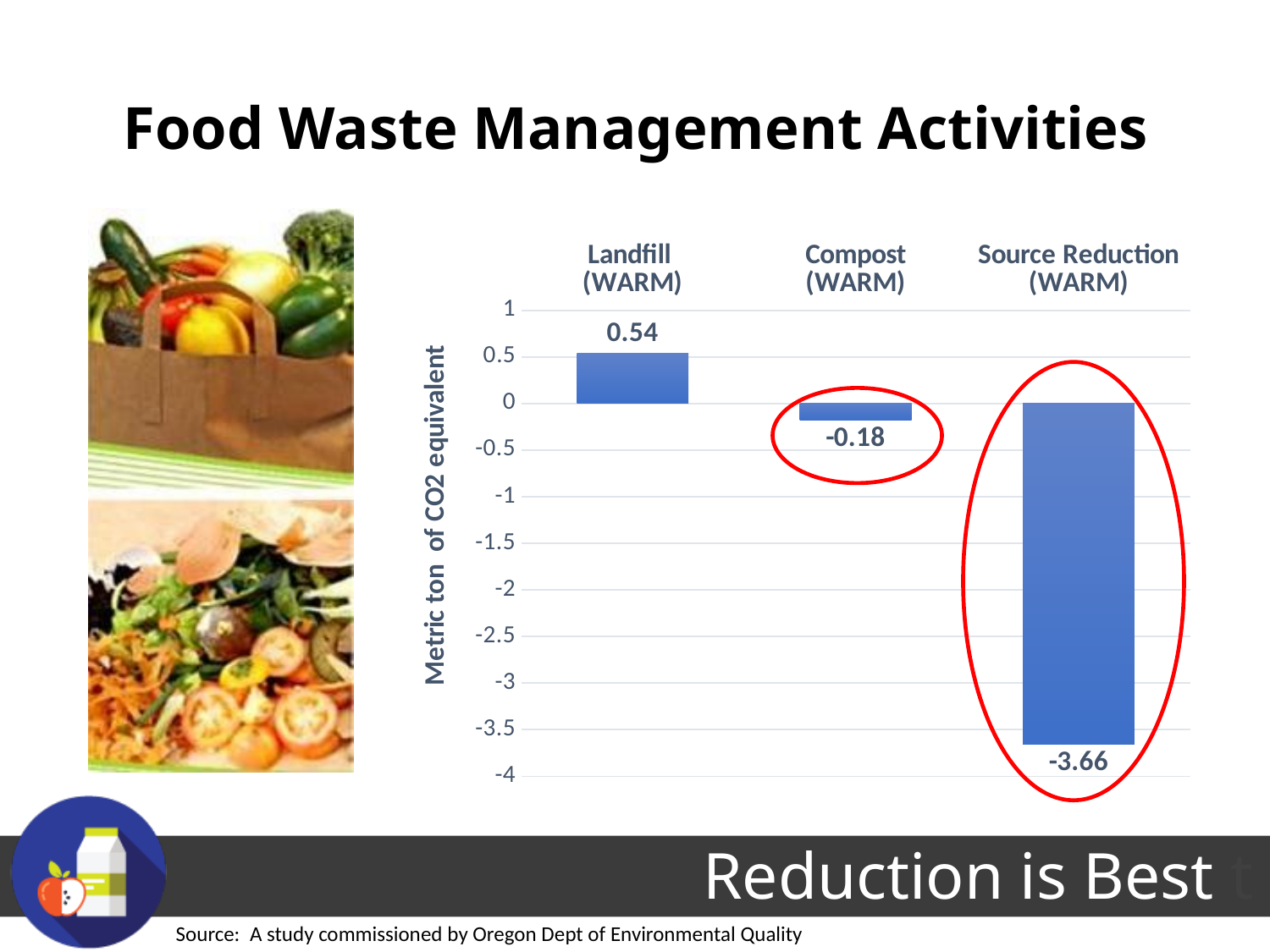
What is the value for Compost (WARM)? -0.18 What is the difference between the values for Landfill (WARM) and Compost (WARM)? 0.72 What is the value for Landfill (WARM)? 0.54 Is the value for Source Reduction (WARM) greater or less than -3? less What is the difference between the values for Compost (WARM) and Source Reduction (WARM)? 3.48 Which category has the lowest value? Source Reduction (WARM) How many categories are shown in the chart? 3 Which category has the highest value? Landfill (WARM) What kind of chart is shown on the slide? bar chart What is the label of the vertical axis of the chart? Metric ton of CO2 equivalent What is the value for Source Reduction (WARM)? -3.66 Which is larger, the value for Compost (WARM) or the value for Source Reduction (WARM)? Compost (WARM)